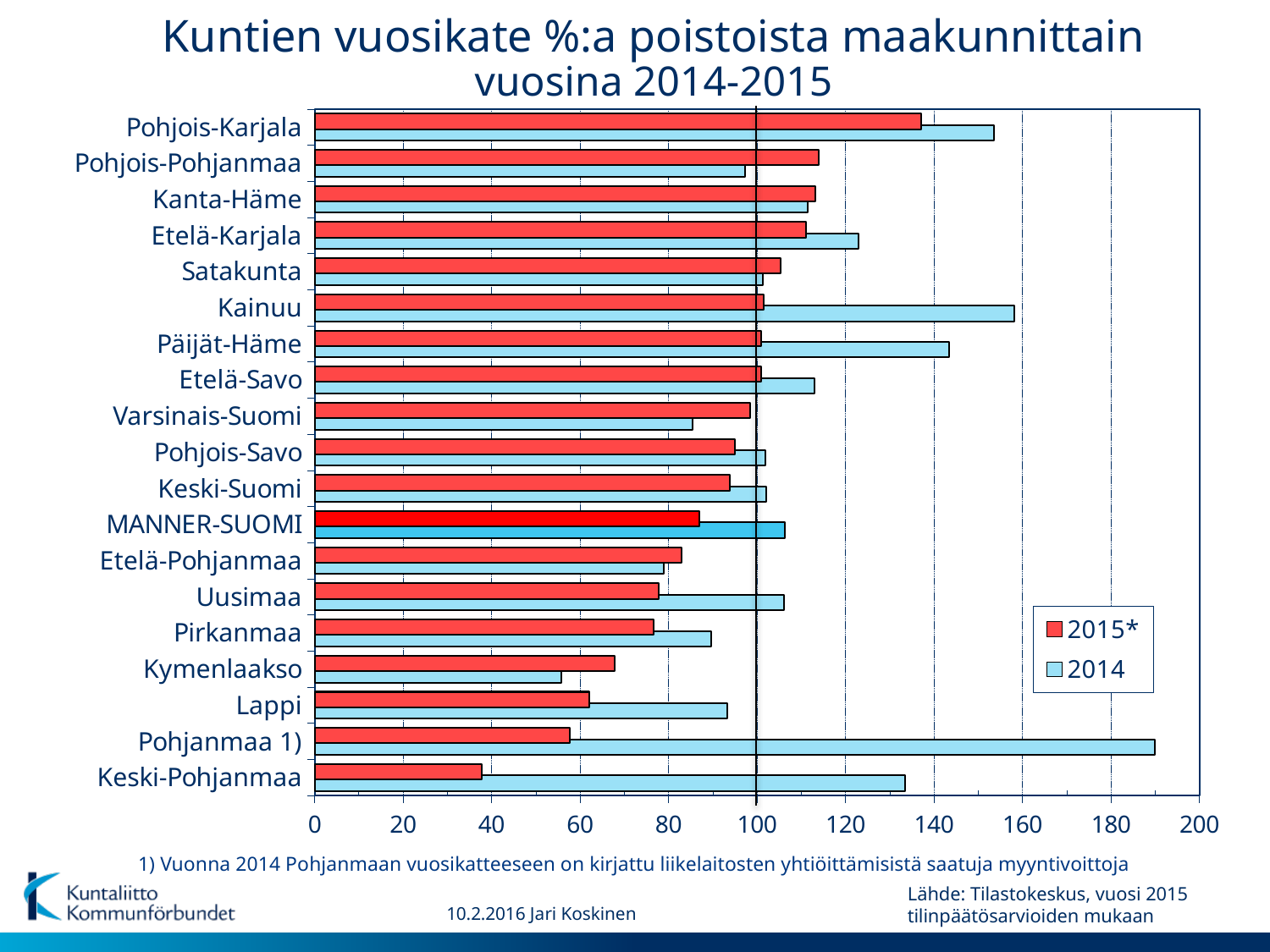
Which region has the highest value for the 2015* series? Pohjois-Karjala Which region has the lowest value for the 2015* series? Keski-Pohjanmaa Is the 2014 value for Pirkanmaa greater or less than 100? less How many regions (categories) are plotted on the chart? 19 How many series does the legend list? 2 What are the two series names shown in the legend? 2015* and 2014 What kind of chart is shown on the slide? bar chart Is the 2015* value for Keski-Pohjanmaa greater or less than 60? less For Pohjois-Pohjanmaa, which series has the larger value, 2015* or 2014? 2015* Which region has the highest value for the 2014 series? Pohjanmaa 1) Is the 2014 value for Kainuu greater or less than 140? greater Which region has the lowest value for the 2014 series? Kymenlaakso